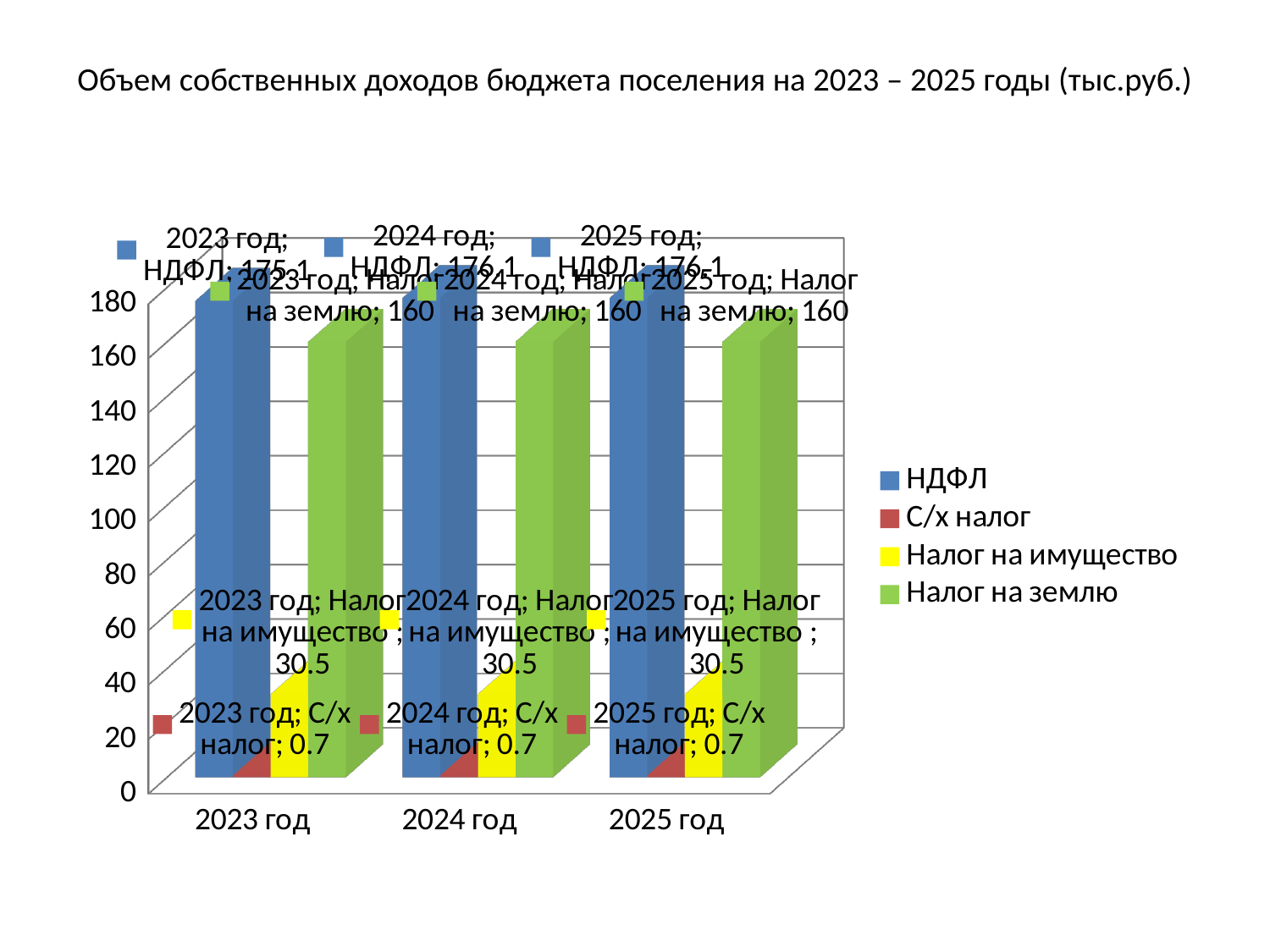
How many series does the legend list? 4 What is the value of С/х налог for 2023 год? 0.7 Which is larger in 2023 год: Налог на имущество or С/х налог? Налог на имущество What is the value of Налог на имущество for 2024 год? 30.5 What kind of chart is shown on the slide? Bar chart Which series has the highest value in 2023 год? НДФЛ What is the value of Налог на землю for 2025 год? 160 What is the difference between НДФЛ and Налог на землю in 2024 год? 16.1 What is the value of НДФЛ for 2024 год? 176.1 How many categories (years) are shown on the x axis? 3 Which series has the lowest value in 2025 год? С/х налог What is the value of НДФЛ for 2023 год? 175.1